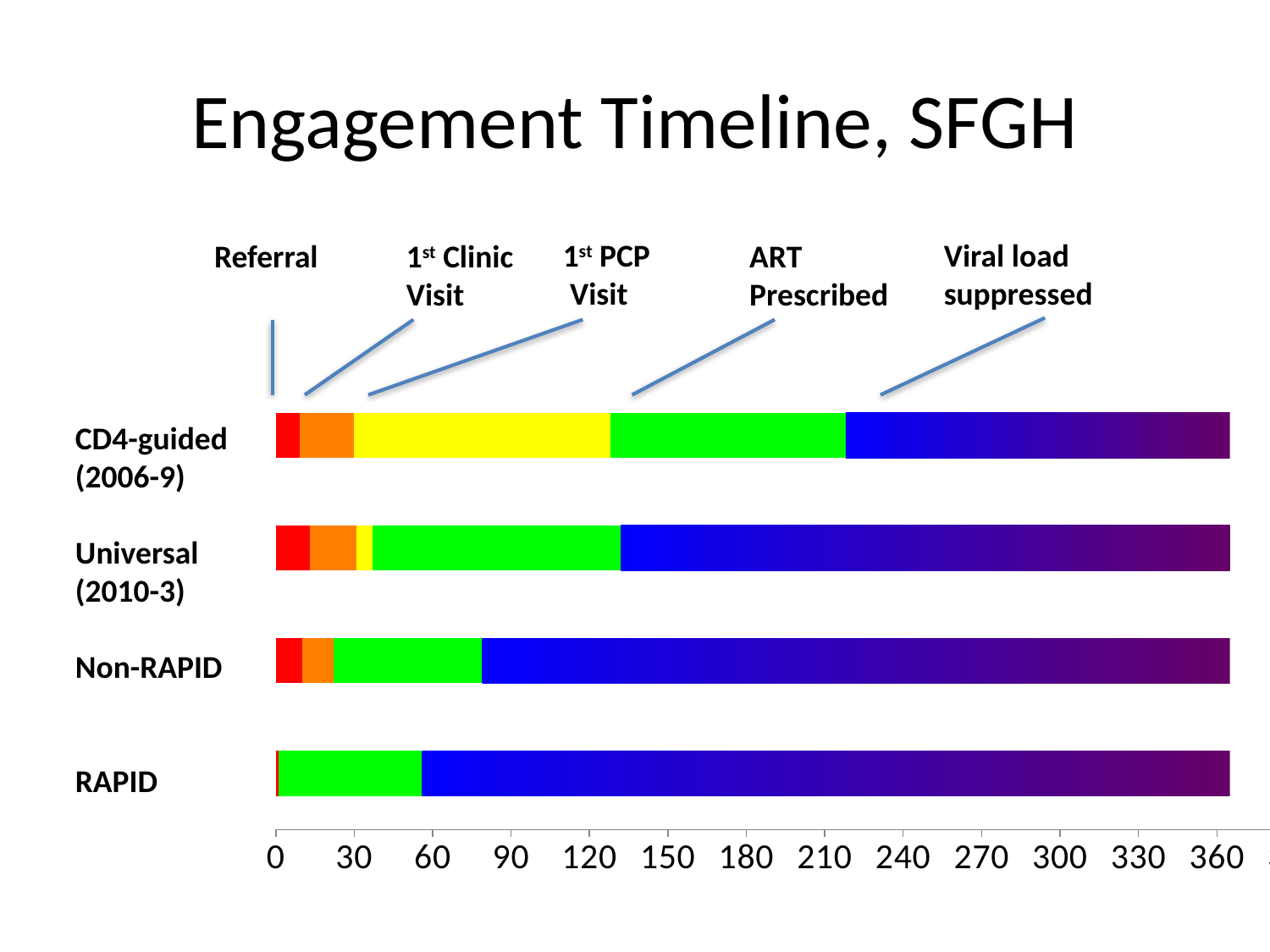
What kind of chart is shown on the slide? Stacked bar chart Which group reaches the Viral load suppressed stage later, Universal (2010-3) or Non-RAPID? Universal (2010-3) How many engagement stages are labelled above the bars? 5 Is the day on which the Viral load suppressed stage begins for RAPID greater or less than 90? less How many groups (bars) are shown in the chart? 4 Which group reaches the Viral load suppressed stage latest? CD4-guided (2006-9) Is the day on which the Viral load suppressed stage begins for Non-RAPID greater or less than 120? less What colour represents the ART Prescribed stage in the bars? Green Is the day on which the Viral load suppressed stage begins for Universal (2010-3) greater or less than 90? greater What is the title of the chart? Engagement Timeline, SFGH Which group reaches the Viral load suppressed stage earliest? RAPID